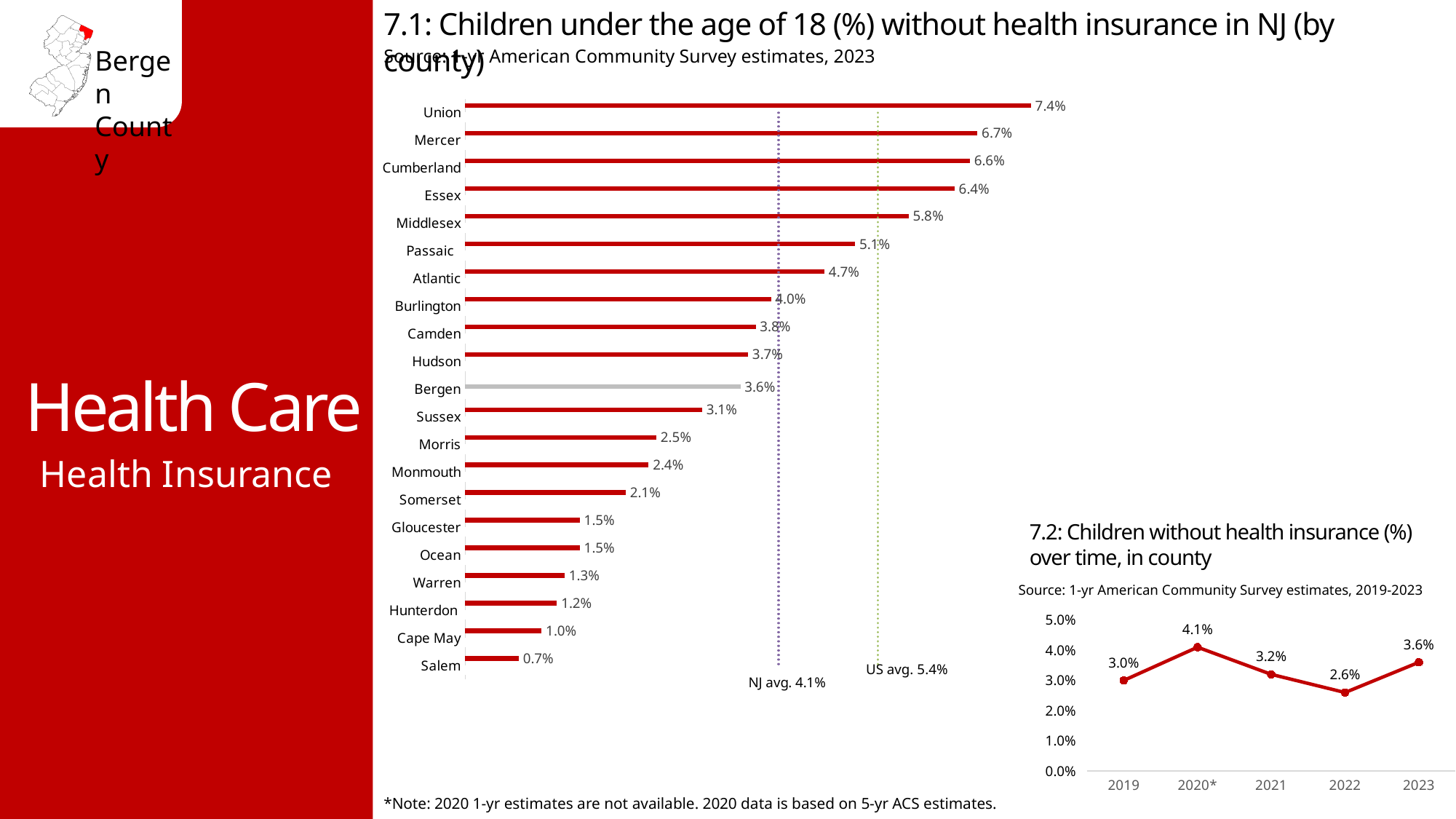
In chart 7.1, which county has a larger value, Passaic or Atlantic? Passaic In chart 7.2, which year has the highest value? 2020* What kind of chart is chart 7.2 (children without health insurance over time)? Line chart In chart 7.1, what NJ average is marked by the dotted reference line? 4.1% In chart 7.1 (children under 18 without health insurance by county), what is the value for Bergen? 3.6% In chart 7.2, what is the difference between the values for 2023 and 2022? 1.0% In chart 7.1, how many counties are shown? 21 In chart 7.1, what is the value for Middlesex? 5.8% In chart 7.1, what is the difference between the values for Union and Salem? 6.7% In chart 7.1, which county has the highest percentage of children without health insurance? Union In chart 7.1, which county has the lowest percentage of children without health insurance? Salem In chart 7.2, what is the value for 2022? 2.6%